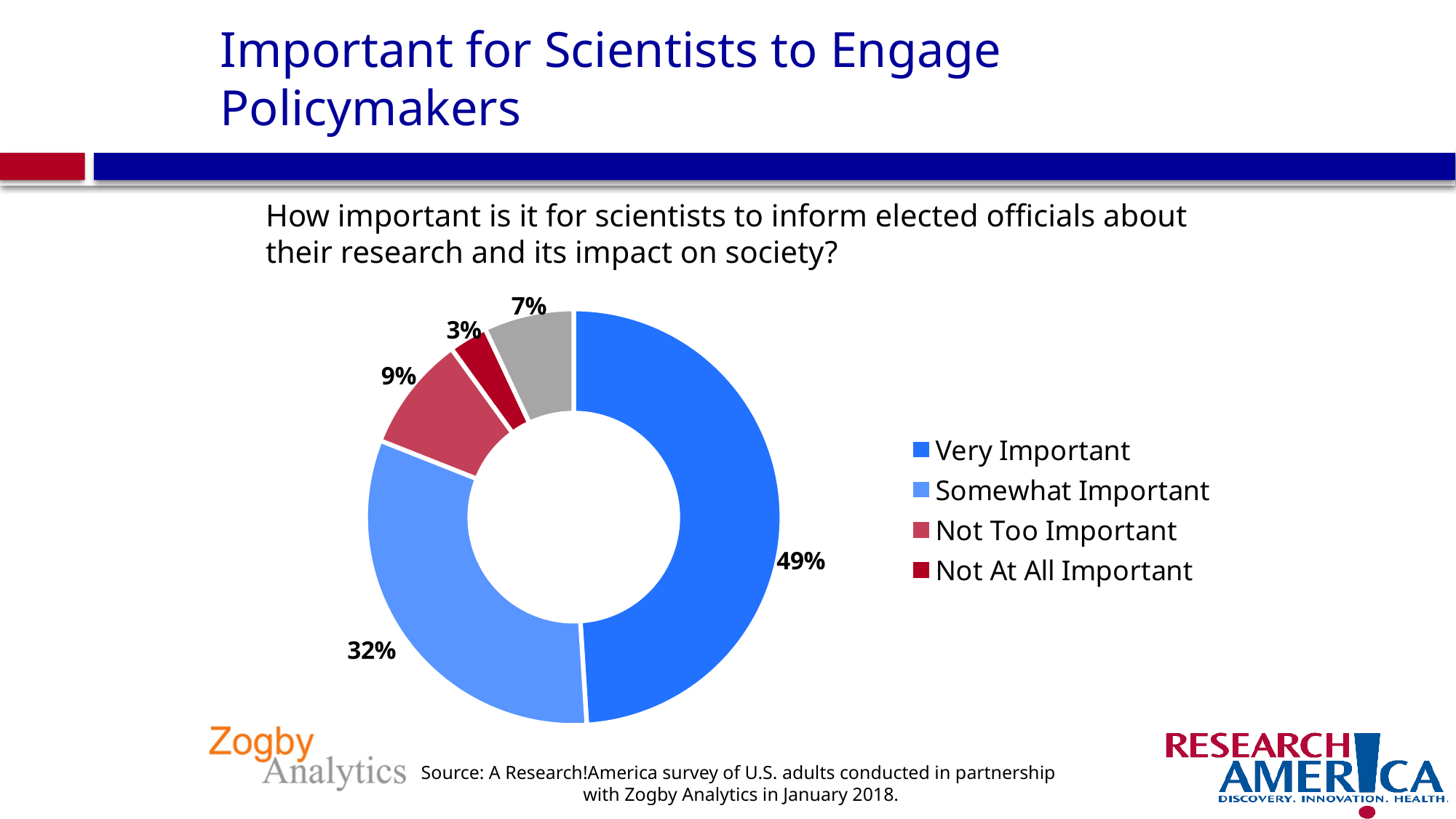
What percentage of respondents chose Somewhat Important? 32% How many slices does the chart have? 5 What is the difference in percentage points between Very Important and Somewhat Important? 17 What percentage of respondents chose Not Too Important? 9% Which legend category has the smallest share of the chart? Not At All Important What is the combined percentage of respondents who said Very Important or Somewhat Important? 81% Which is larger, the share for Not Too Important or the share for Not At All Important? Not Too Important How many entries does the legend list? 4 What type of chart is shown on the slide? Doughnut (pie) chart Which response category has the largest share of the chart? Very Important What percentage of respondents said it is Very Important for scientists to inform elected officials about their research? 49% What percentage of respondents chose Not At All Important? 3%